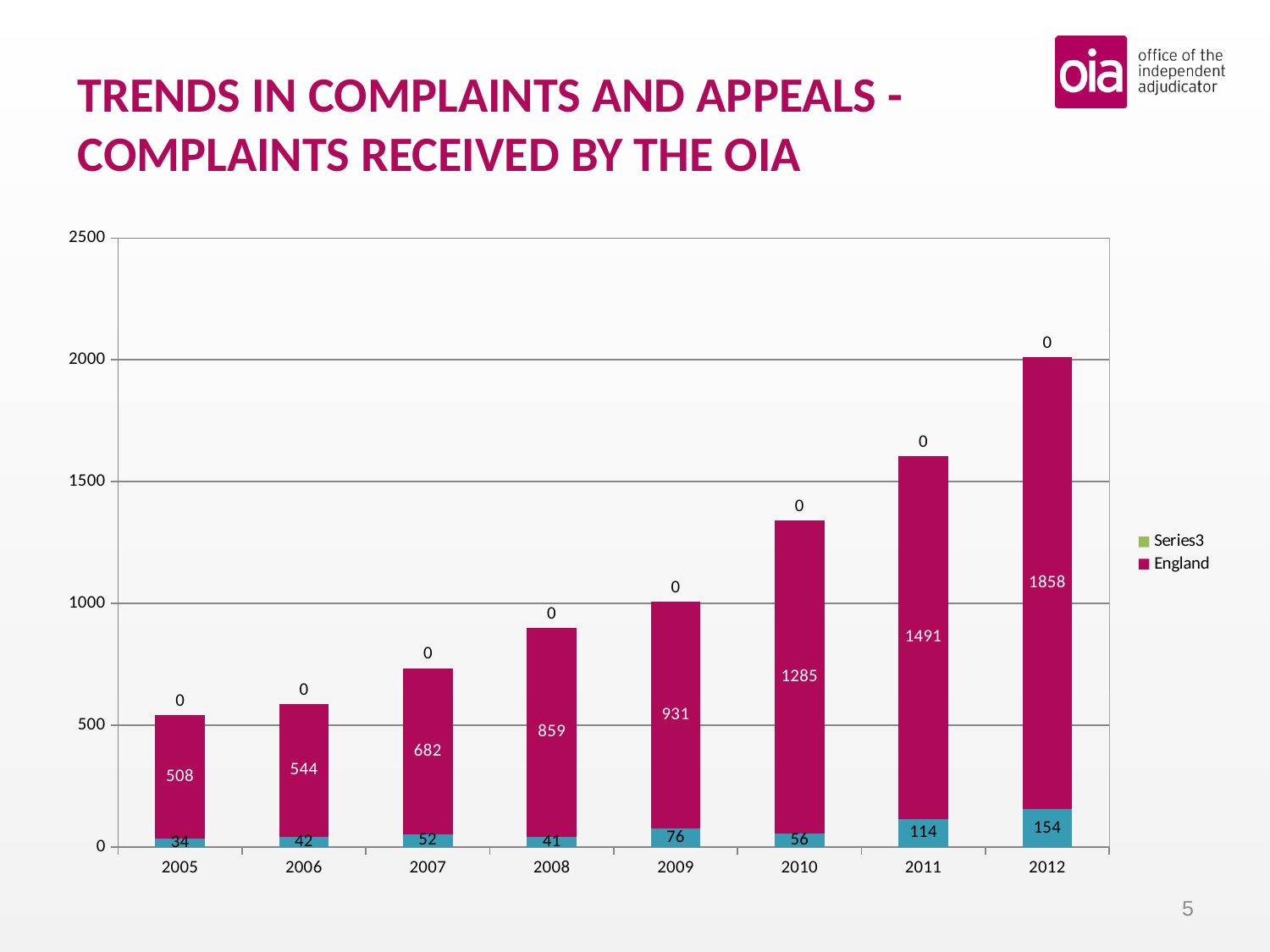
How many years are shown on the x axis? 8 Which year has the lowest value for England? 2005 What is the value for England in 2005? 508 Do the England values rise or fall from 2005 to 2012? Rise Is the total height of the 2010 stacked bar greater or less than 1500? less What kind of chart is shown on the slide? Stacked bar chart Which year has the highest value for England? 2012 What is the value for England in 2009? 931 How many series does the legend list? 2 Which is larger, the England value for 2008 or for 2009? 2009 What is the value for England in 2012? 1858 What is the difference between the England values for 2012 and 2011? 367